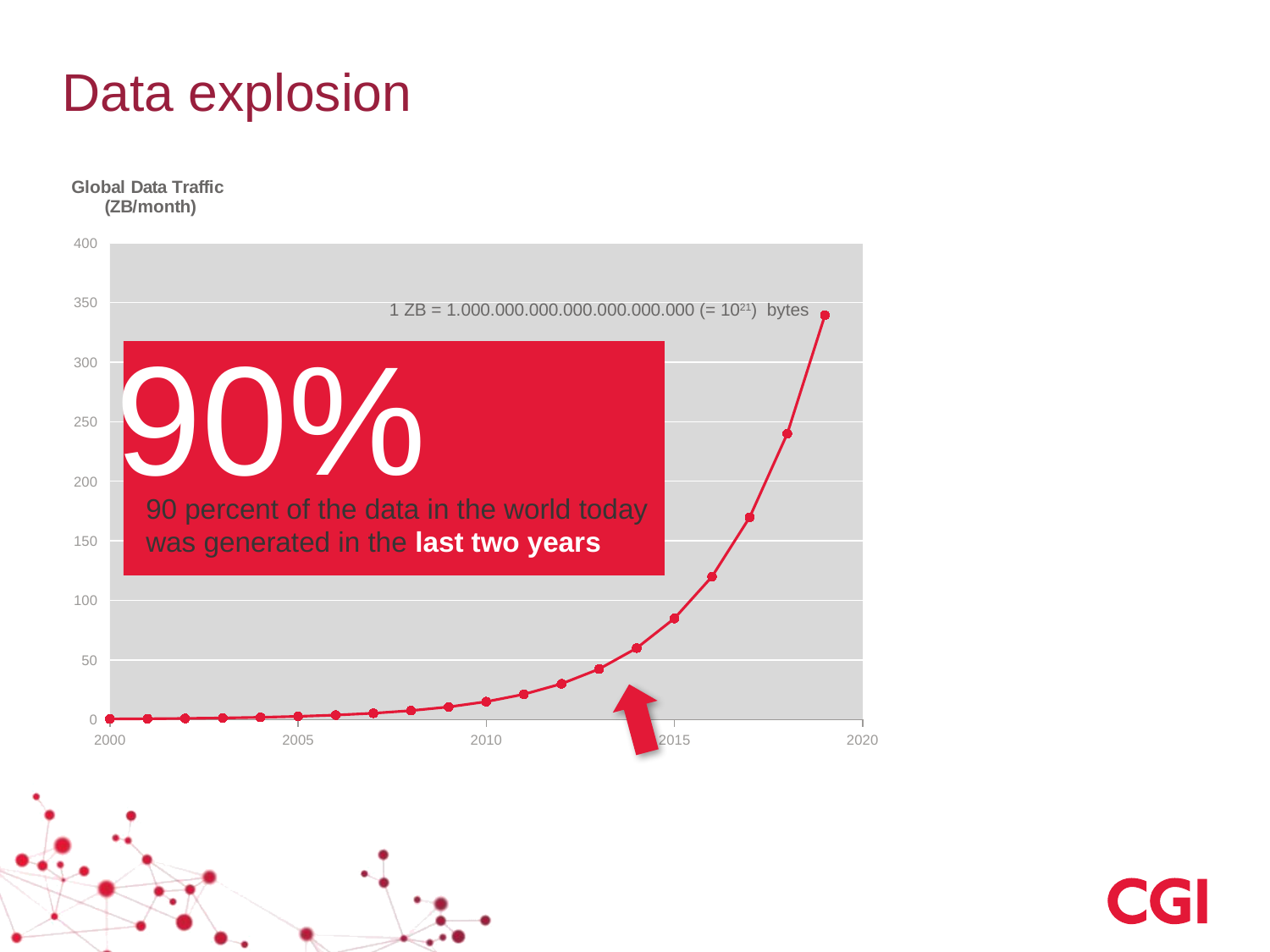
Which is larger, the value for 2018 or the value for 2015? 2018 What unit is the y axis of the chart measured in? ZB/month Which year has the lowest value on the chart? 2000 How many data points are plotted on the line? 20 Is the value for 2018 greater or less than 200? greater What kind of chart is shown on the slide? line chart Do the values rise or fall along the x axis from 2000 to 2020? rise Is the value for 2019 greater or less than 300? greater Is the value for 2010 greater or less than 50? less What is the title of the chart? Global Data Traffic (ZB/month) Which year has the highest value on the chart? 2019